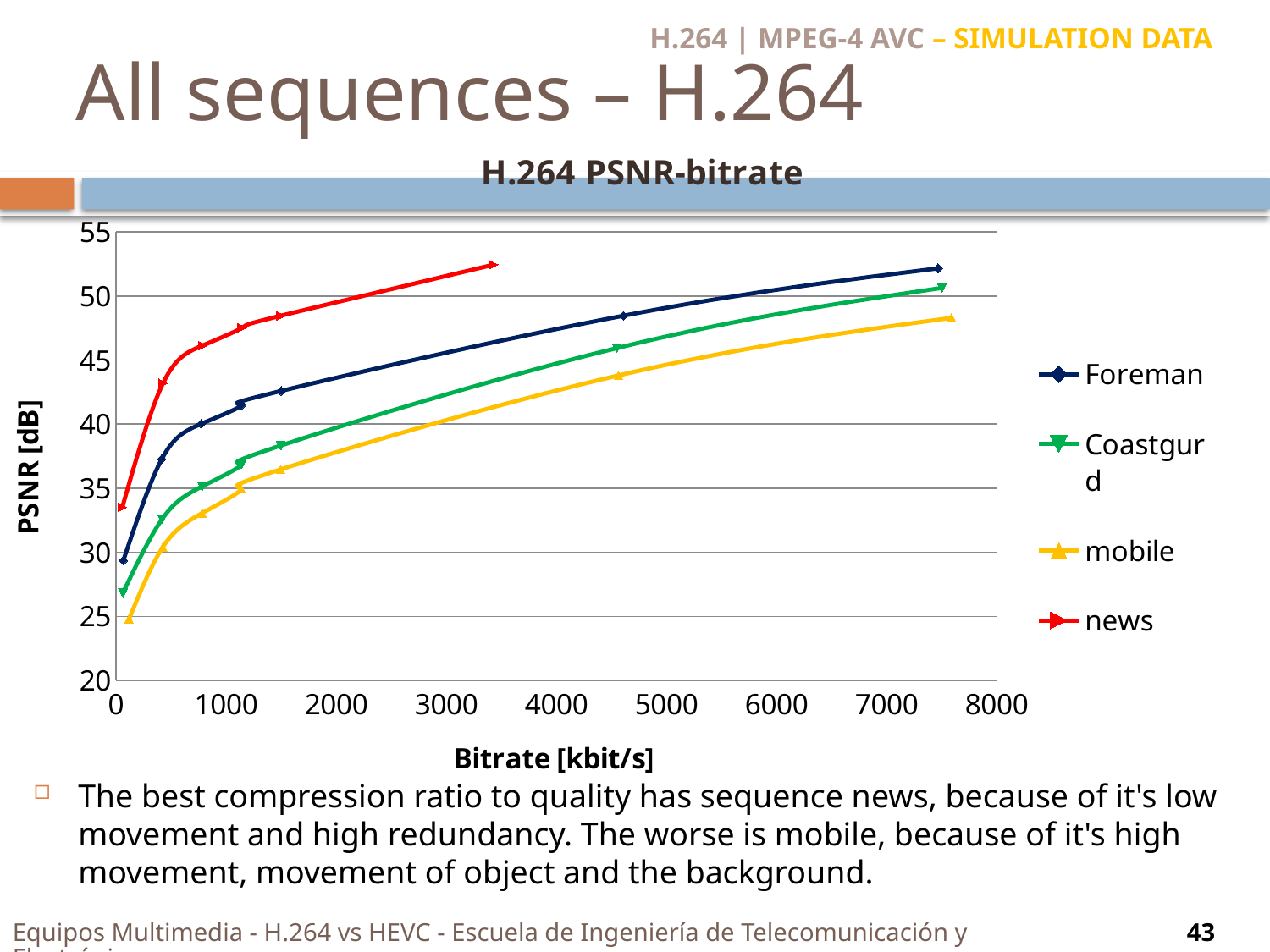
Which series has the lowest PSNR across the plotted bitrate range? mobile Is the highest PSNR value reached by the news series greater or less than 50? greater Which series ends at the lowest maximum bitrate? news Is the lowest PSNR value of the news series greater or less than 35? less Does the PSNR of the Foreman series rise or fall as bitrate increases? rise Which series has the highest PSNR at a bitrate of 1000 kbit/s? news What kind of chart is shown on the slide? line chart Is the highest PSNR value reached by the mobile series greater or less than 50? less What is the label of the vertical axis? PSNR [dB] How many series does the legend list? 4 At a bitrate of about 1000 kbit/s, which series has the higher PSNR, Foreman or mobile? Foreman What is the title of the chart? H.264 PSNR-bitrate